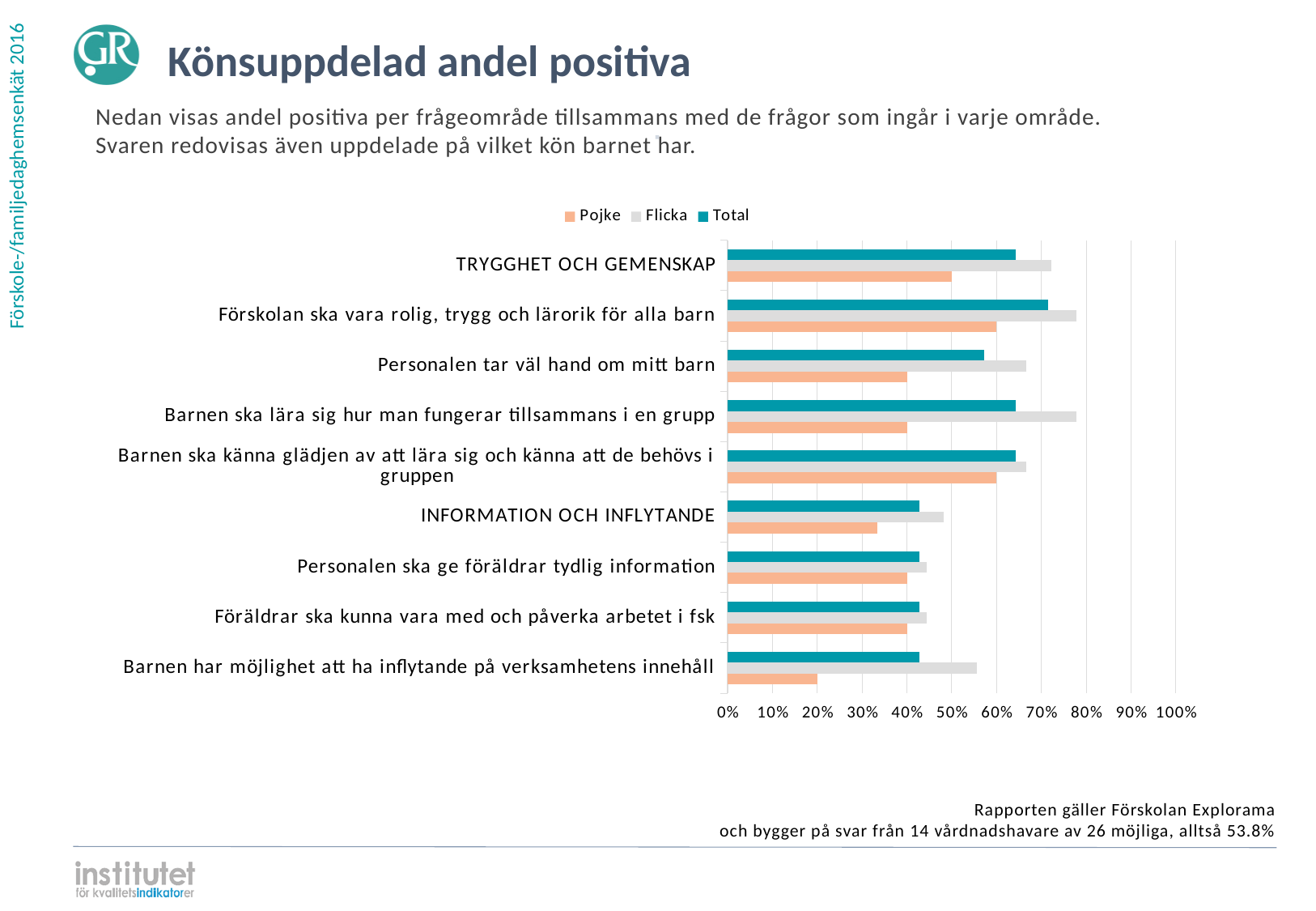
Which category has the lowest Pojke value? Barnen har möjlighet att ha inflytande på verksamhetens innehåll How many categories (question areas and questions) are shown on the y axis of the chart? 9 Which is larger: the Total value for 'TRYGGHET OCH GEMENSKAP' or the Total value for 'INFORMATION OCH INFLYTANDE'? TRYGGHET OCH GEMENSKAP How many series does the legend of the chart list? 3 What kind of chart is shown on the slide? Bar chart Is the Flicka value for 'Förskolan ska vara rolig, trygg och lärorik för alla barn' greater or less than 70%? greater Is the Total value for 'INFORMATION OCH INFLYTANDE' greater or less than 50%? less Is the Pojke value for 'Barnen har möjlighet att ha inflytande på verksamhetens innehåll' greater or less than 30%? less What is the title of the slide containing the chart? Könsuppdelad andel positiva Which category has the highest Total value? Förskolan ska vara rolig, trygg och lärorik för alla barn What are the three series listed in the chart legend? Pojke, Flicka, Total For 'Personalen tar väl hand om mitt barn', which is larger: the Pojke value or the Flicka value? Flicka